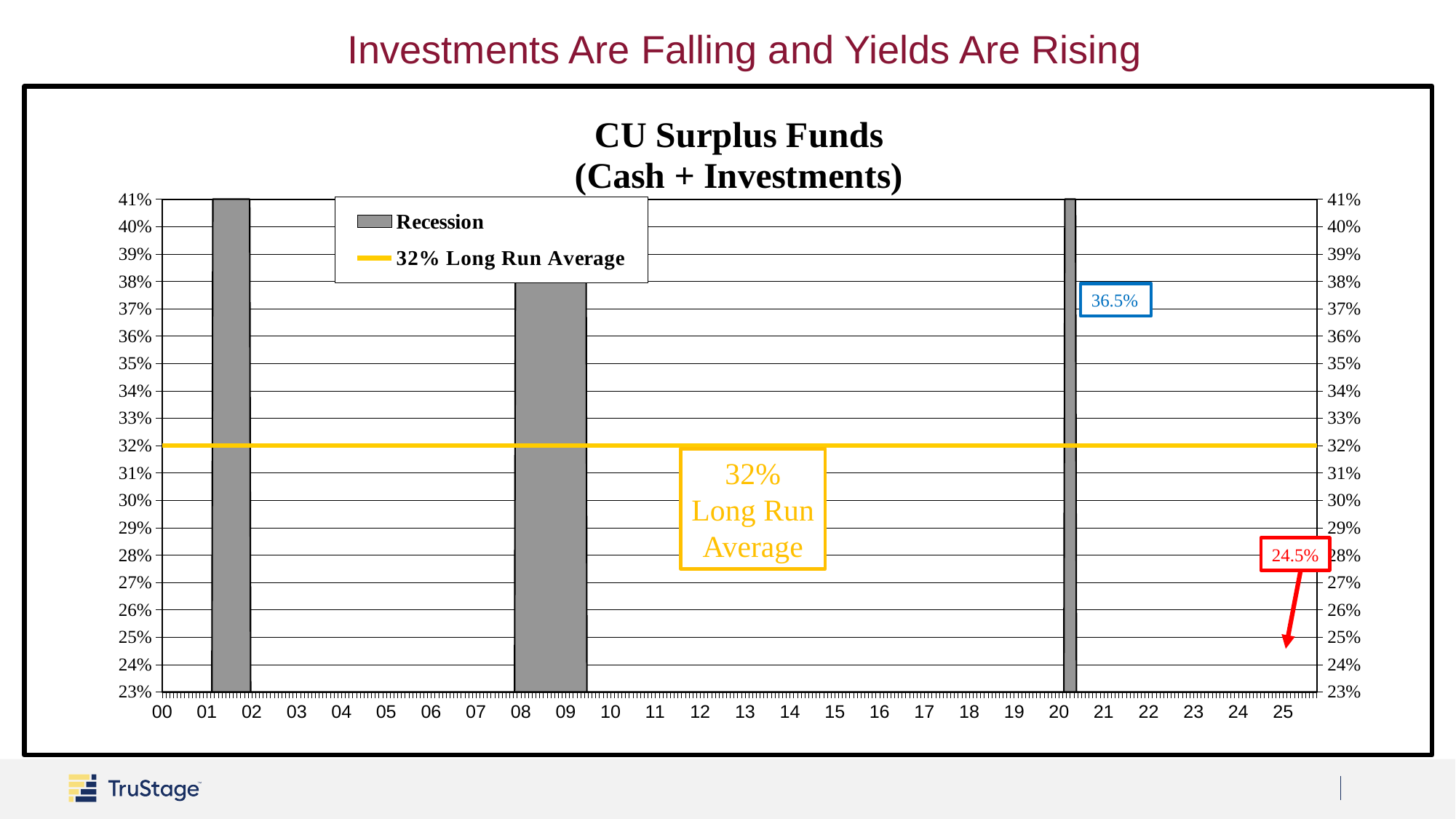
What is the title of the chart? CU Surplus Funds (Cash + Investments) Is the long run average line greater or less than 30%? greater Is the annotated value near 2025 (24.5%) greater or less than the 32% long run average? less What value is shown in the blue annotation box near 2021? 36.5% How many shaded recession periods are shown on the chart? 3 What value is the long run average line drawn at? 32% How many entries does the chart legend list? 2 What value is shown in the red annotation box near 2025? 24.5% What are the two entries in the chart legend? Recession; 32% Long Run Average Which annotated value is larger, the one near 2021 or the one near 2025? The one near 2021 (36.5%) What is the difference between the annotated value near 2021 (36.5%) and the annotated value near 2025 (24.5%)? 12 percentage points How many year labels are shown on the x axis? 26